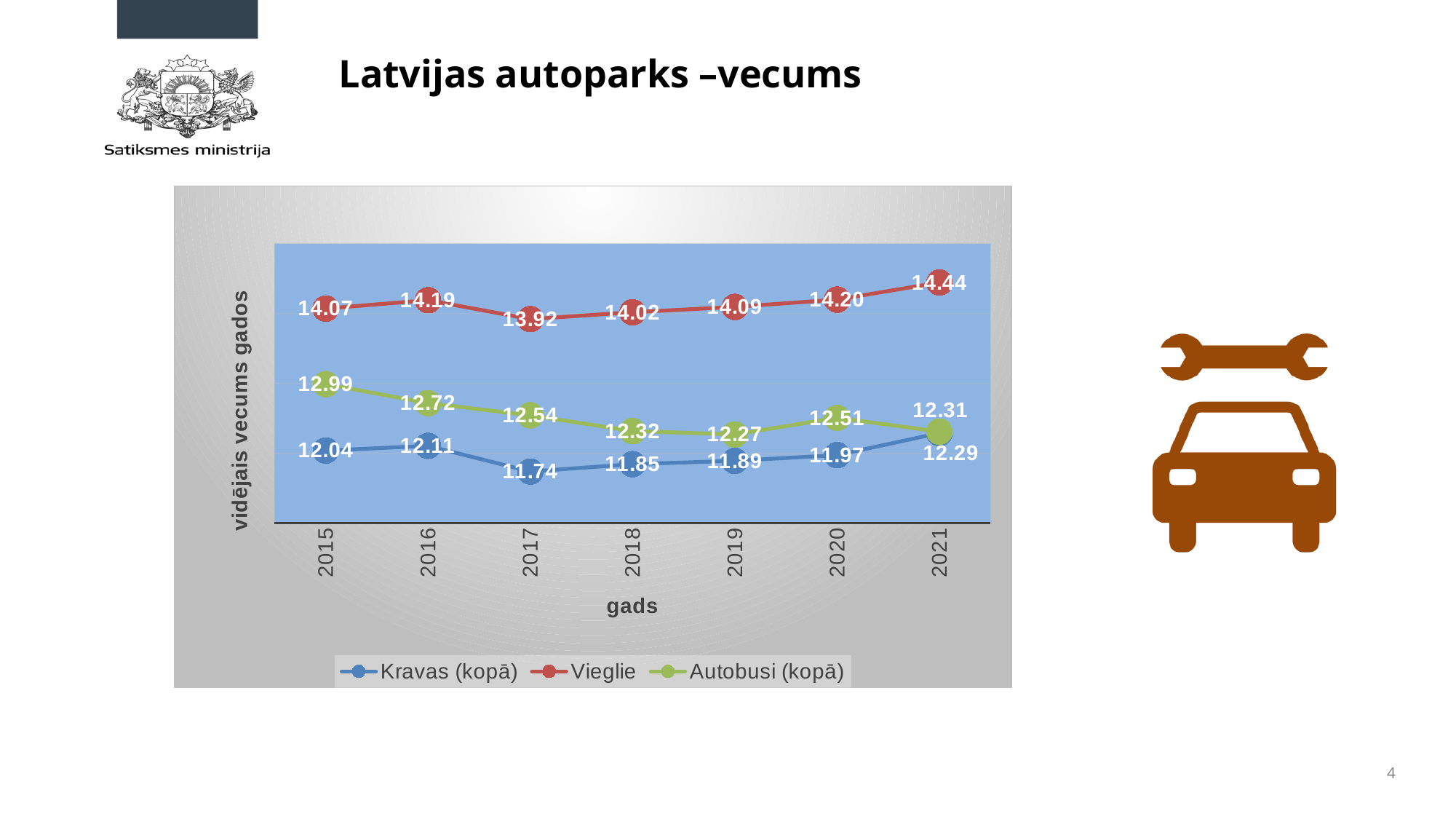
In which year is the Vieglie value lowest? 2017 What is the difference between the Vieglie value in 2021 and in 2015? 0.37 Does the Autobusi (kopā) value rise or fall from 2015 to 2018? Fall What is the label of the y axis? vidējais vecums gados What kind of chart is shown on the slide? Line chart How many years are shown on the x axis? 7 What is the value for Autobusi (kopā) in 2015? 12.99 How many series does the legend list? 3 What is the value for Vieglie in 2021? 14.44 Which series has the higher value in 2018, Vieglie or Autobusi (kopā)? Vieglie In which year is the Kravas (kopā) value highest? 2021 What is the value for Kravas (kopā) in 2017? 11.74